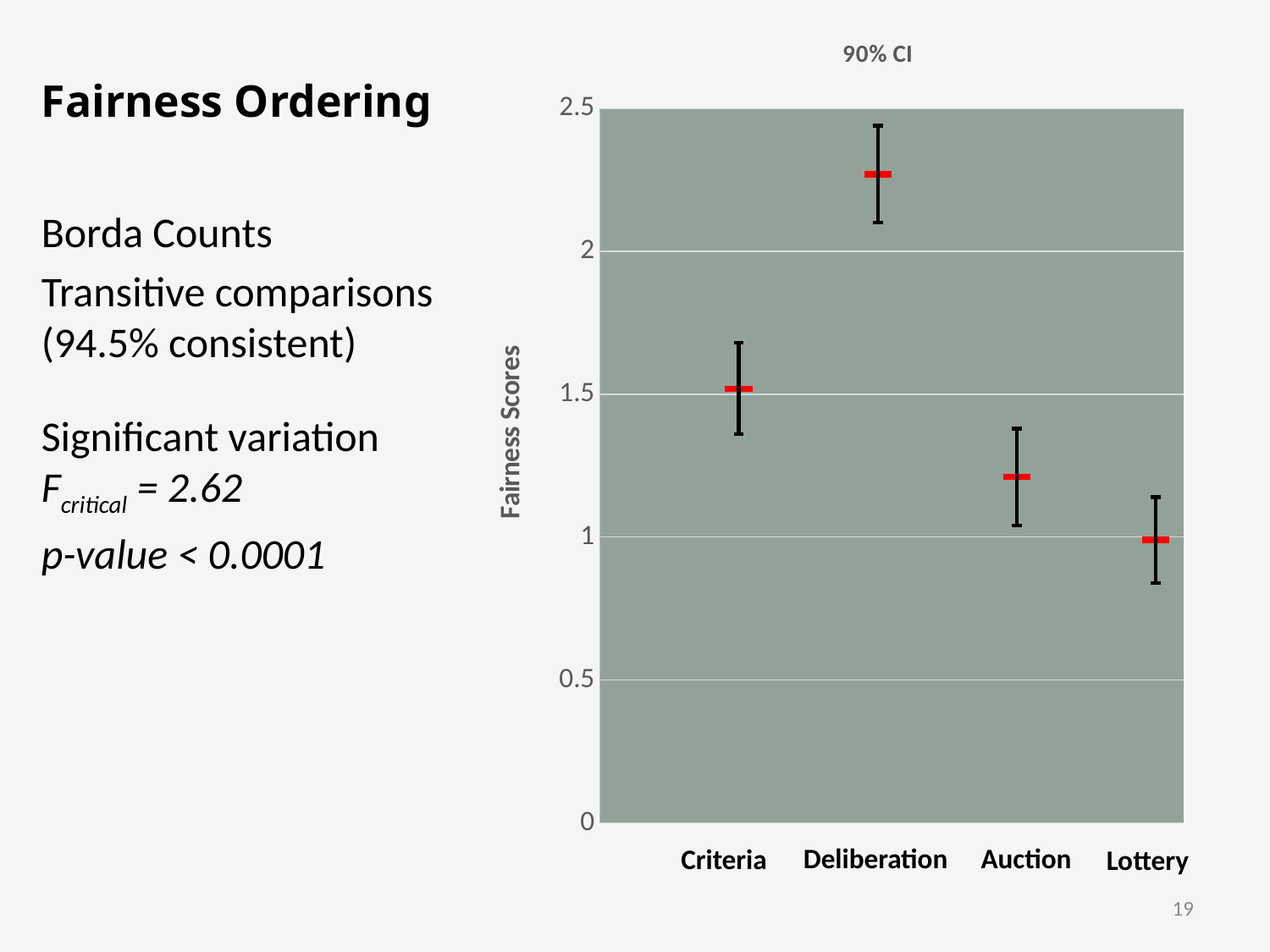
Is the fairness score for Criteria greater or less than 1? greater What is the label of the y axis? Fairness Scores Which category has the lowest fairness score? Lottery Is the fairness score for Deliberation greater or less than 2? greater What is the title of the chart? 90% CI Which has a higher fairness score, Deliberation or Lottery? Deliberation Which has a higher fairness score, Criteria or Auction? Criteria How many categories are shown on the x axis? 4 Do the fairness scores rise or fall from Deliberation to Lottery along the x axis? fall Is the fairness score for Lottery greater or less than 1.5? less Which category has the highest fairness score? Deliberation